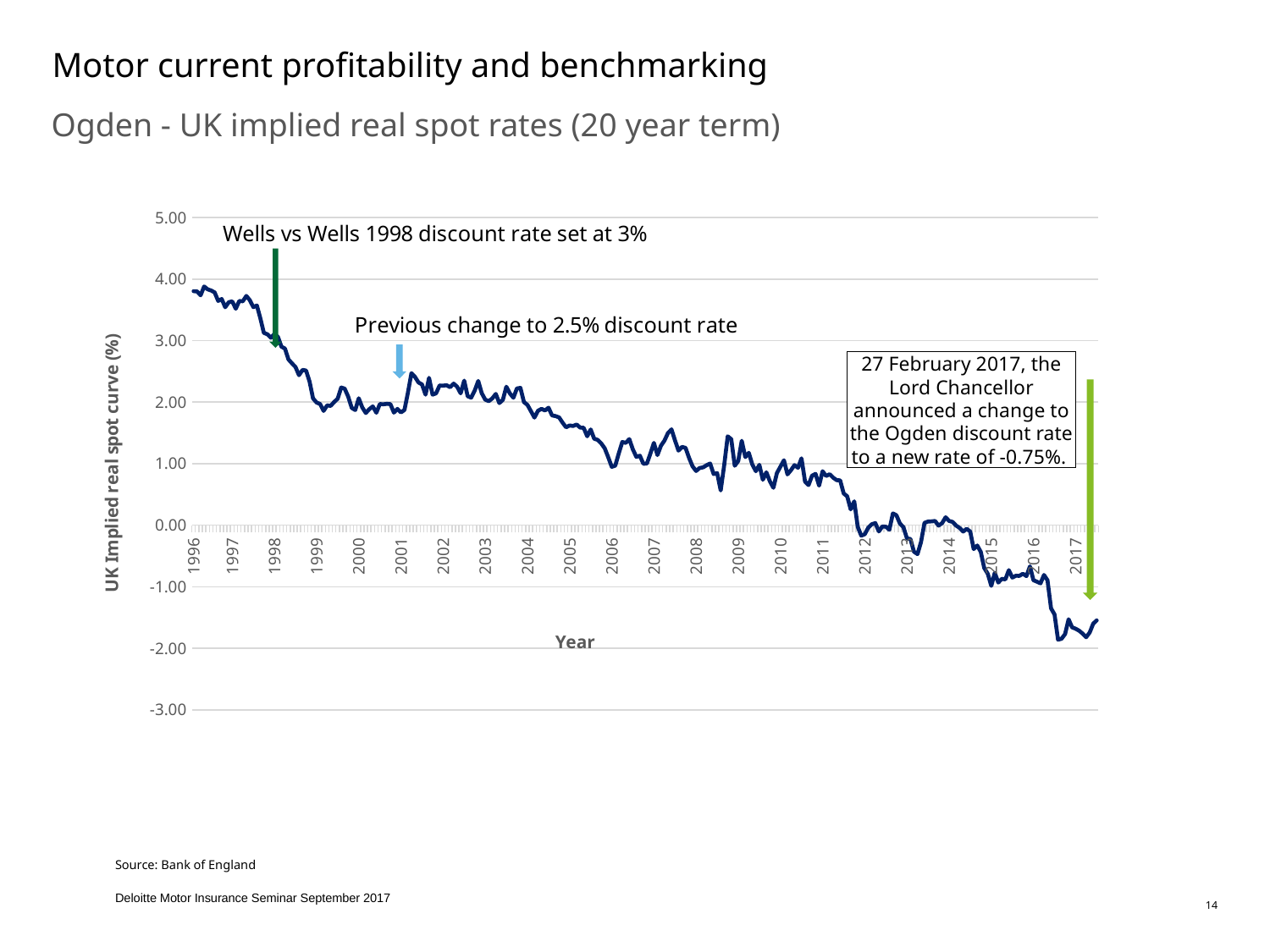
Is the value around 2005 greater or less than 1.00? greater Which year label on the x axis corresponds to the highest values on the line? 1996 What is the title of the vertical axis? UK Implied real spot curve (%) Is the value around 2001 greater or less than 3.00? less Is the value at the end of the series in 2017 greater or less than -1.00? less Which is larger: the value at the start of the series (1996) or at the end (2017)? 1996 Overall, do the UK implied real spot rates rise or fall from 1996 to 2017? fall What kind of chart is shown on the slide? line chart How many year labels are shown on the x axis? 22 According to the annotation box, what new Ogden discount rate was announced on 27 February 2017? -0.75%